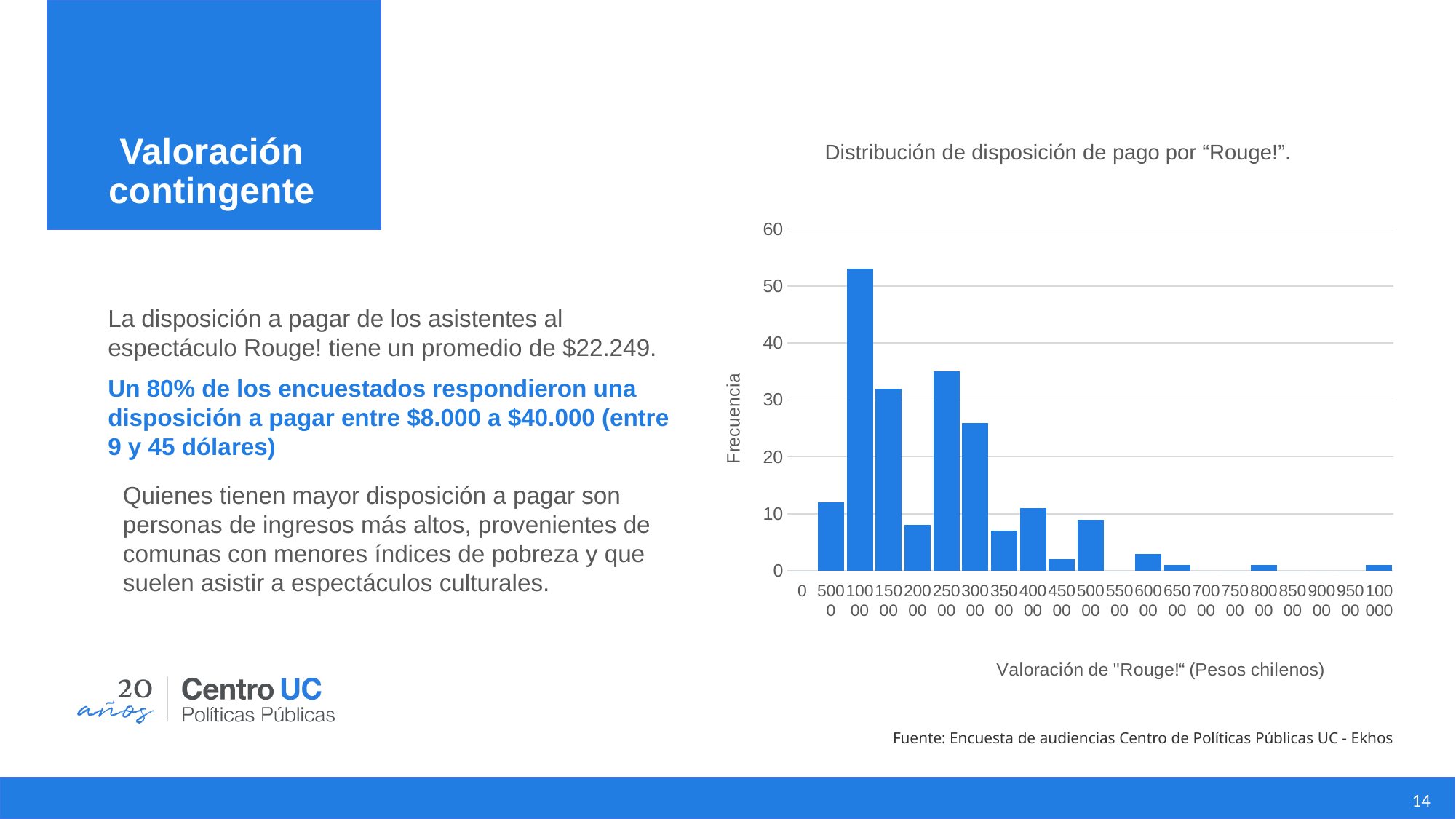
Is the frequency for 5000 greater or less than 10? greater Is the frequency for 20000 greater or less than 10? less Which has a higher frequency, 25000 or 30000? 25000 Is the frequency for 35000 greater or less than 10? less What is the label of the vertical axis of the chart? Frecuencia What kind of chart is shown on the slide? bar chart Which has a higher frequency, 5000 or 20000? 5000 What is the title of the chart? Distribución de disposición de pago por "Rouge!". Which value on the x axis has the highest frequency? 10000